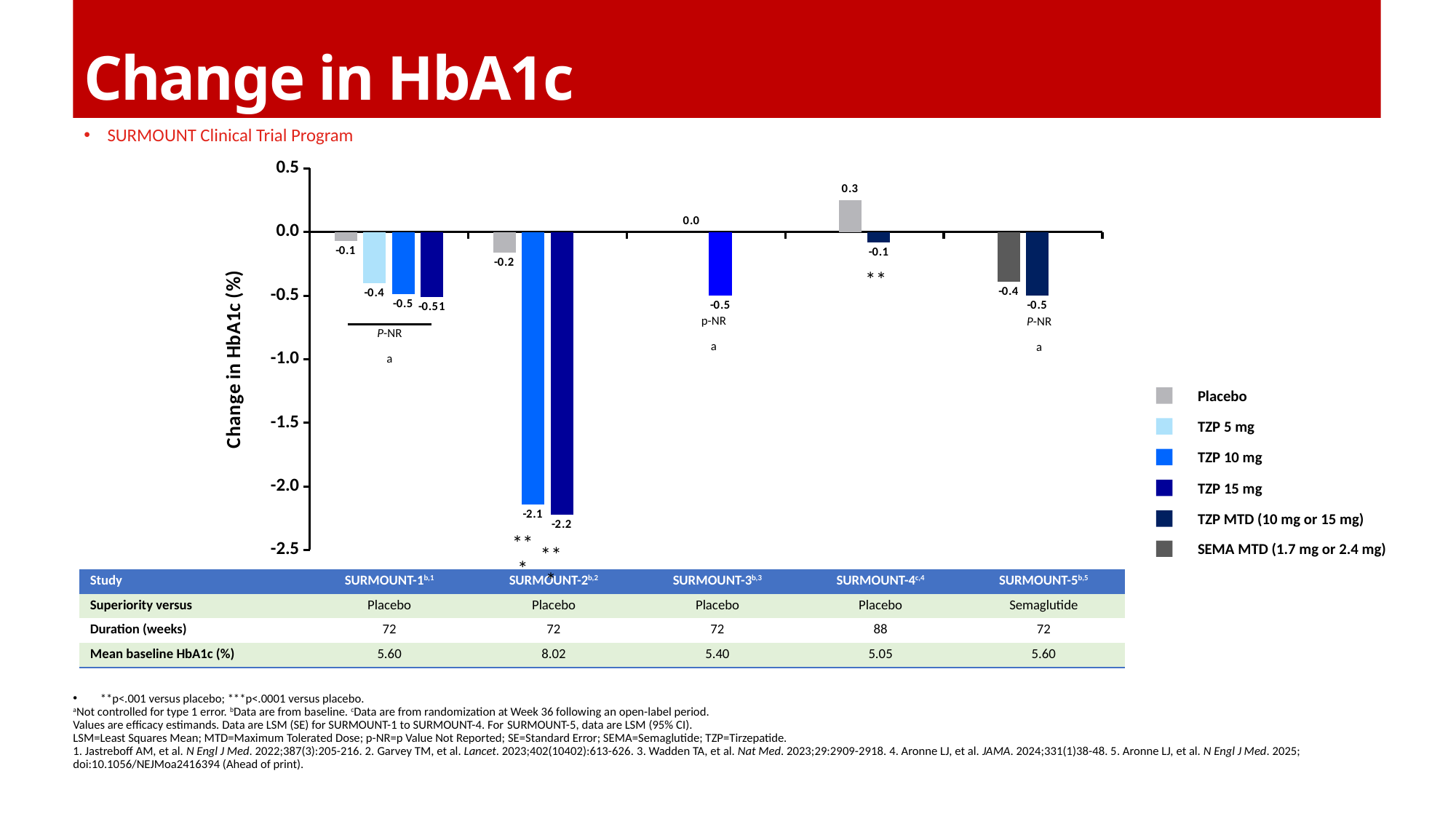
What is the change in HbA1c for placebo in SURMOUNT-4? 0.3 What is the change in HbA1c for TZP 15 mg in SURMOUNT-1? -0.51 How many series does the legend list? 6 What is the title of the y axis? Change in HbA1c (%) In SURMOUNT-2, what is the difference between the placebo value (-0.2) and the TZP 15 mg value (-2.2)? 2.0 What is the change in HbA1c for TZP 10 mg in SURMOUNT-2? -2.1 What is the change in HbA1c for SEMA MTD in SURMOUNT-5? -0.4 What is the change in HbA1c for placebo in SURMOUNT-3? 0.0 How many studies are shown along the x axis of the chart? 5 What kind of chart is shown on the slide? bar chart What is the change in HbA1c for TZP 15 mg in SURMOUNT-2? -2.2 Which bar shows the lowest value (largest reduction) in the chart? TZP 15 mg in SURMOUNT-2 (-2.2)